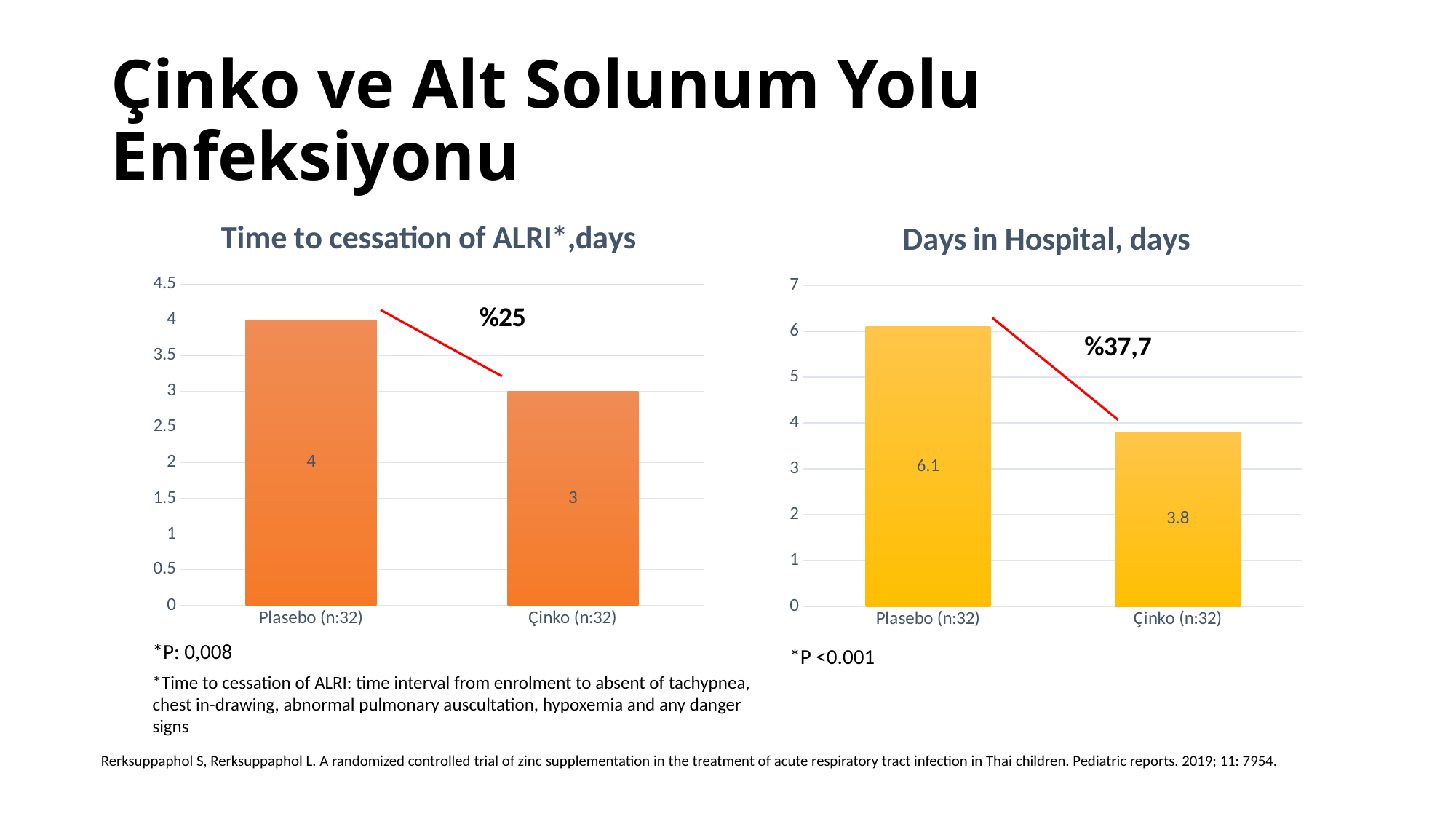
In the 'Time to cessation of ALRI*,days' chart, what is the value for Çinko (n:32)? 3 In the 'Days in Hospital, days' chart, what is the value for Çinko (n:32)? 3.8 In the 'Time to cessation of ALRI*,days' chart, what is the difference between the Plasebo (n:32) and Çinko (n:32) values? 1 In the 'Days in Hospital, days' chart, what is the value for Plasebo (n:32)? 6.1 In the 'Time to cessation of ALRI*,days' chart, which category has the lowest value? Çinko (n:32) How many categories are shown in the 'Time to cessation of ALRI*,days' chart? 2 What percentage reduction is annotated on the 'Days in Hospital, days' chart? %37,7 What type of chart is the 'Days in Hospital, days' chart? bar chart In the 'Time to cessation of ALRI*,days' chart, what is the value for Plasebo (n:32)? 4 In the 'Days in Hospital, days' chart, what is the difference between the Plasebo (n:32) and Çinko (n:32) values? 2.3 In the 'Days in Hospital, days' chart, which category has the highest value? Plasebo (n:32) In the 'Days in Hospital, days' chart, is the value for Çinko (n:32) greater or less than 4? less